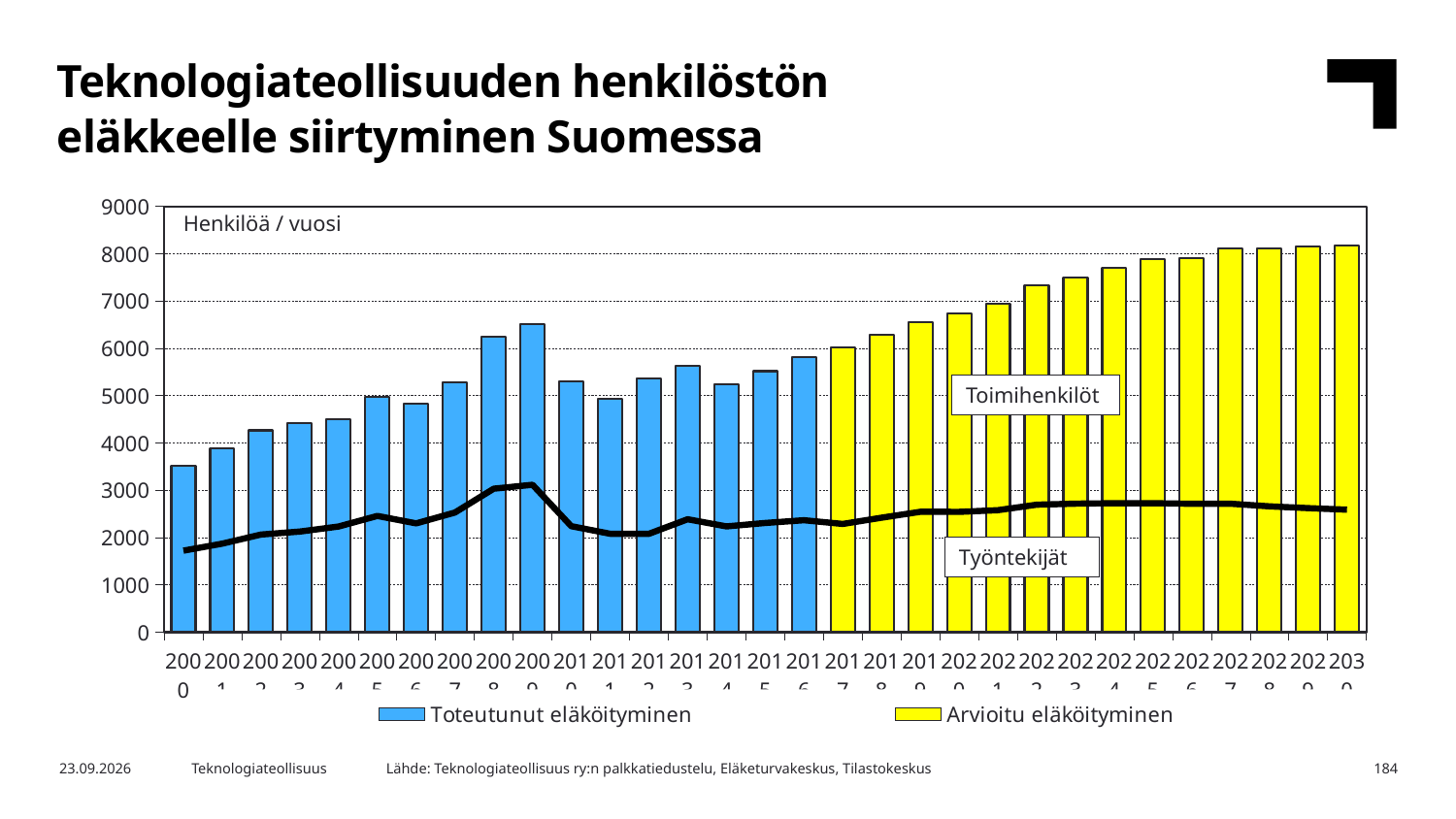
How many years are shown on the x axis? 31 What colour are the 'Arvioitu eläköityminen' bars? yellow Which bar is taller, 2009 or 2010? 2009 What kind of chart is shown on the slide? combination bar and line chart Is the bar for 2009 greater or less than 6000? greater Is the bar for 2000 greater or less than 4000? less How many series does the legend list? 2 Among the blue 'Toteutunut eläköityminen' bars, which year is highest? 2009 Which year has the lowest bar? 2000 Do the bar values rise or fall from 2017 to 2030? rise Is the bar for 2030 greater or less than 8000? greater